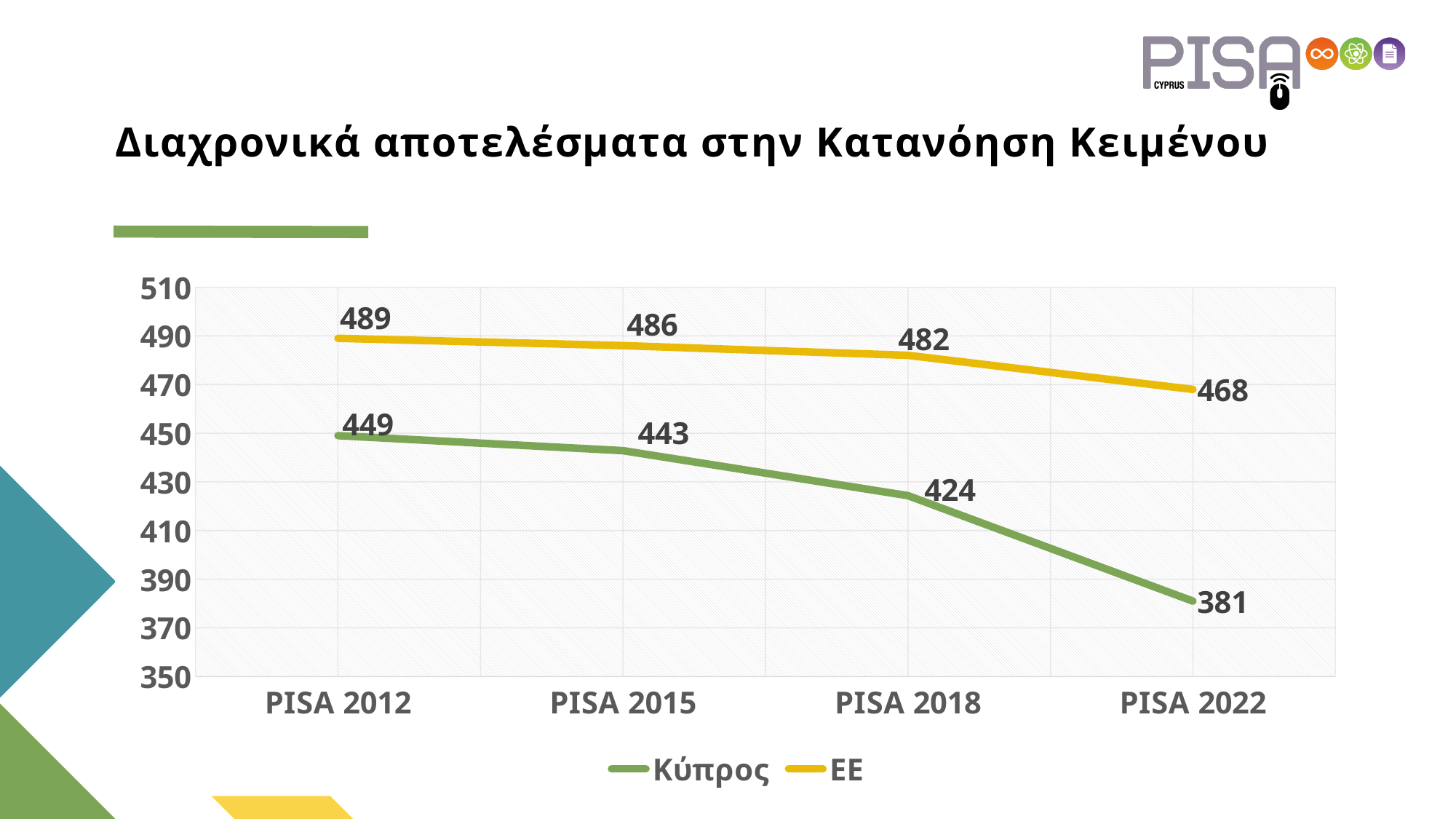
How many PISA cycles are shown on the x axis? 4 What is the value for ΕΕ in PISA 2012? 489 What is the difference between the ΕΕ and Κύπρος values in PISA 2022? 87 Which is larger in PISA 2018, the value for Κύπρος or for ΕΕ? ΕΕ How many series does the legend list? 2 What is the value for Κύπρος in PISA 2022? 381 What is the value for Κύπρος in PISA 2015? 443 In which PISA cycle is the value for ΕΕ lowest? PISA 2022 In which PISA cycle is the value for Κύπρος highest? PISA 2012 What kind of chart is shown on the slide? Line chart By how much did the Κύπρος value fall from PISA 2018 to PISA 2022? 43 What is the value for ΕΕ in PISA 2018? 482